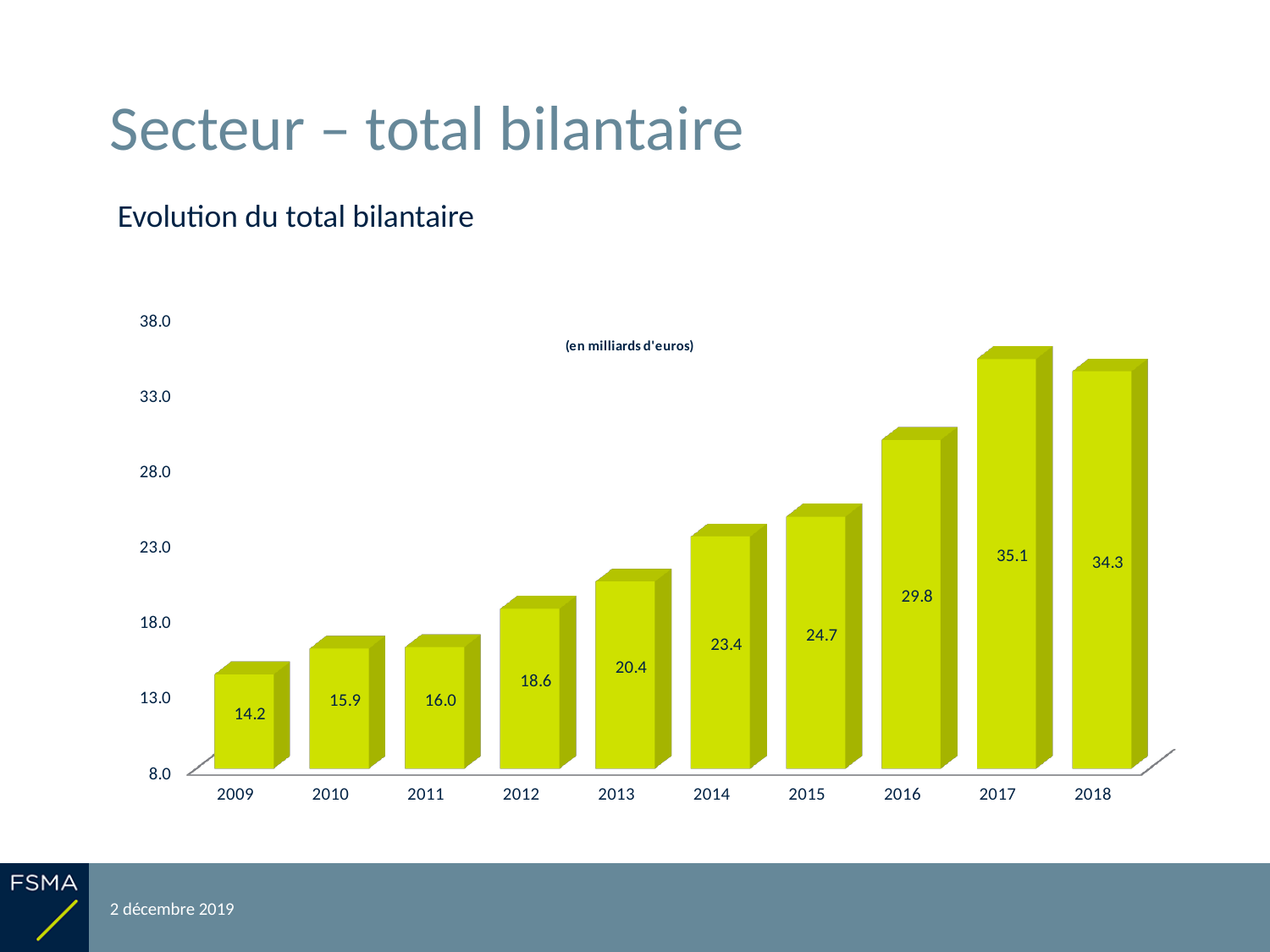
Is the value for 2015 greater or less than 23.0? greater What kind of chart is shown? bar chart In what unit are the values expressed, according to the label on the chart? en milliards d'euros Which year has the highest value? 2017 Which year has the lowest value? 2009 What is the value for 2009? 14.2 What is the value for 2016? 29.8 Which is larger, the value for 2013 or the value for 2014? 2014 How many years are shown on the x axis? 10 What is the value for 2018? 34.3 What is the difference between the values for 2017 and 2018? 0.8 What is the difference between the values for 2016 and 2015? 5.1